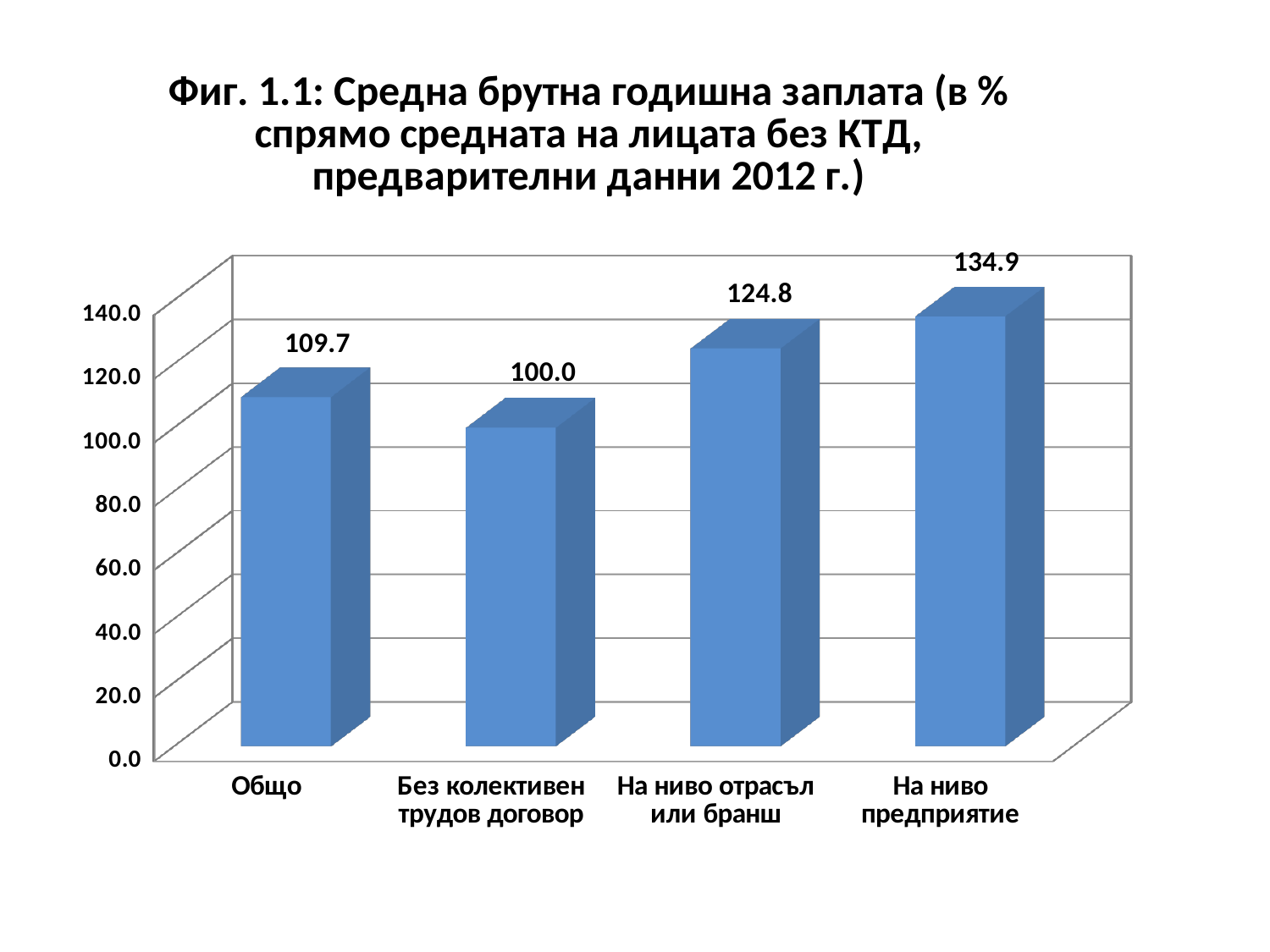
What kind of chart is shown on the slide? Bar chart How many categories are shown in the chart? 4 Which category has the highest value? На ниво предприятие What is the value for На ниво предприятие? 134.9 Which category has the lowest value? Без колективен трудов договор What is the difference between the values for На ниво отрасъл или бранш and Общо? 15.1 What is the value for Без колективен трудов договор? 100.0 Which is larger, the value for Общо or the value for На ниво отрасъл или бранш? На ниво отрасъл или бранш What is the figure number given in the chart title? Фиг. 1.1 What is the value for На ниво отрасъл или бранш? 124.8 What is the value for Общо? 109.7 What is the difference between the values for На ниво предприятие and Без колективен трудов договор? 34.9